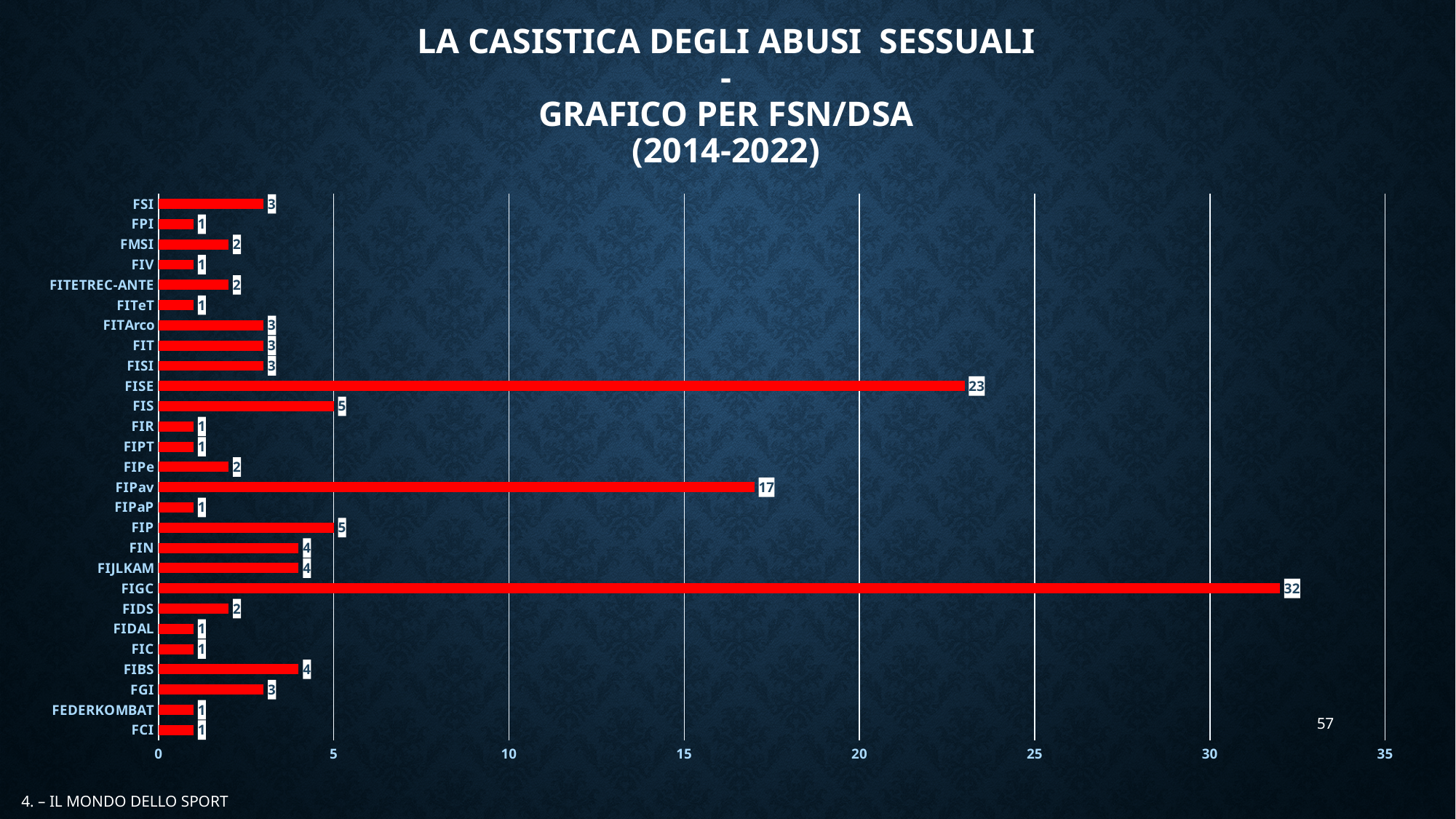
Is the value for FIGC greater or less than 30? greater How many federations are shown on the chart? 27 What kind of chart is shown on the slide? bar chart What is the value for FISE? 23 What is the difference between the values for FIGC and FISE? 9 Which federation has the highest value? FIGC What is the value for FIBS? 4 What period does the chart title say the data covers? 2014-2022 What is the value for FIPav? 17 What is the value for FIGC? 32 What is the difference between the values for FISE and FIPav? 6 Which is larger, the value for FIS or the value for FIN? FIS